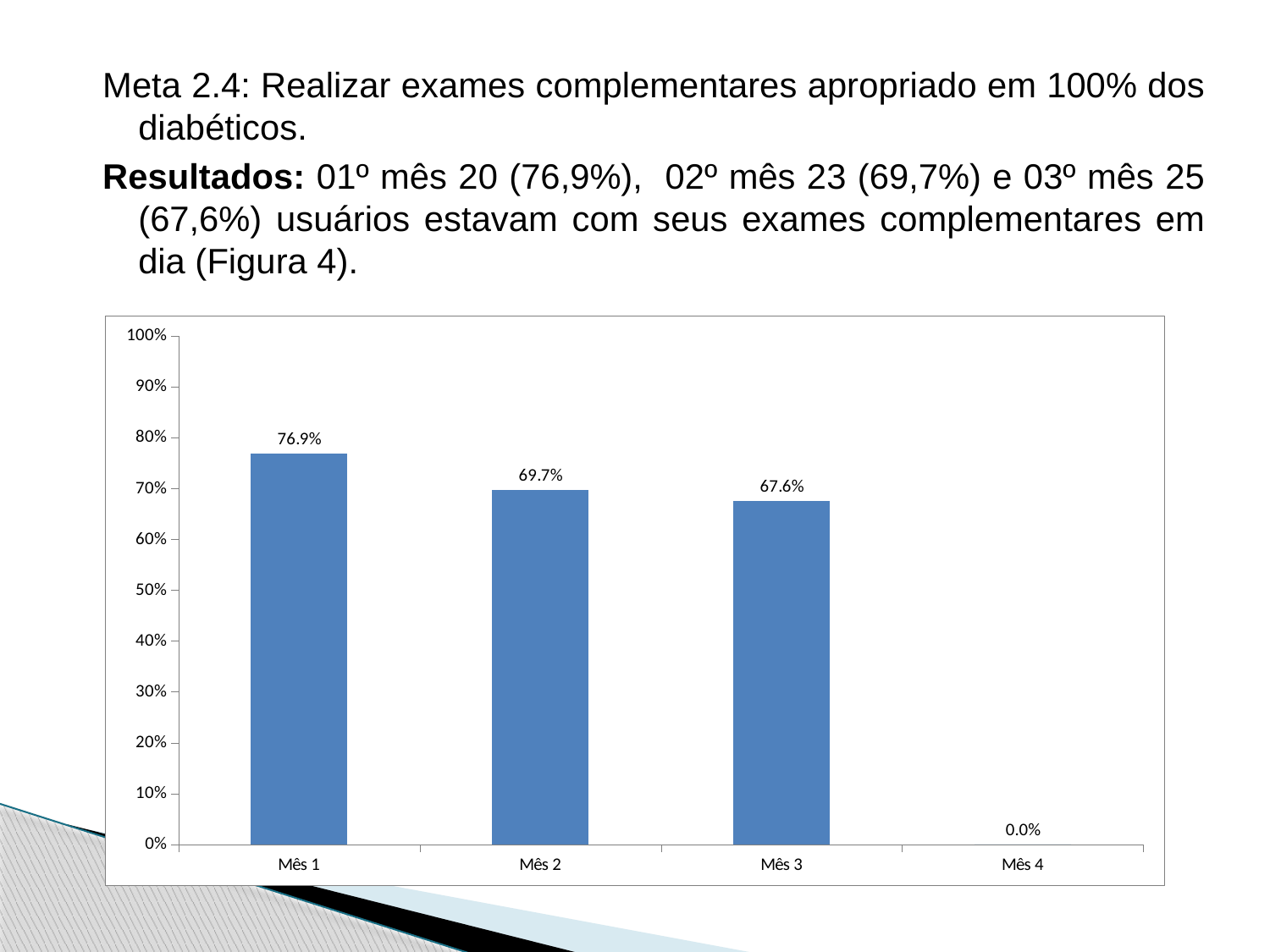
What is the difference between the values for Mês 2 and Mês 3? 2.1% What is the value for Mês 2? 69.7% Which month has the highest value? Mês 1 What is the difference between the values for Mês 1 and Mês 2? 7.2% Is the value for Mês 3 greater or less than 70%? less How many categories are shown on the x axis? 4 What kind of chart is shown on the slide? bar chart What is the value for Mês 3? 67.6% What is the value for Mês 4? 0.0% Which is larger, the value for Mês 1 or the value for Mês 3? Mês 1 What is the value for Mês 1? 76.9% Which month has the lowest value? Mês 4